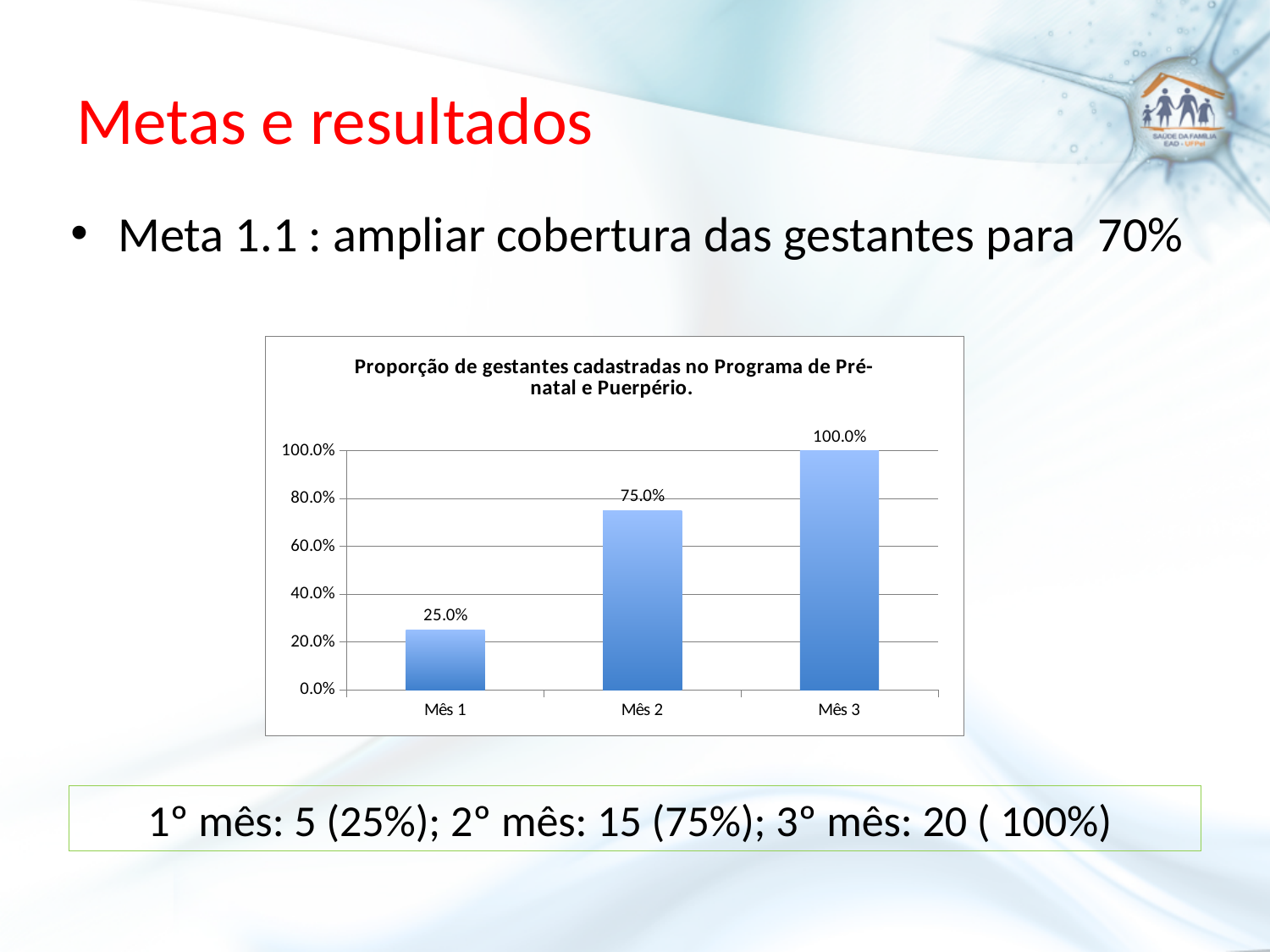
Do the values rise or fall from Mês 1 to Mês 3? Rise What is the difference between the values for Mês 3 and Mês 2? 25.0% What is the value for Mês 1? 25.0% What is the value for Mês 2? 75.0% Which month has the lowest value? Mês 1 Which is larger, the value for Mês 1 or the value for Mês 2? Mês 2 Is the value for Mês 2 greater or less than 60.0%? greater How many months are shown on the x axis? 3 What is the difference between the values for Mês 2 and Mês 1? 50.0% What is the value for Mês 3? 100.0% Which month has the highest value? Mês 3 What kind of chart is shown on the slide? Bar chart